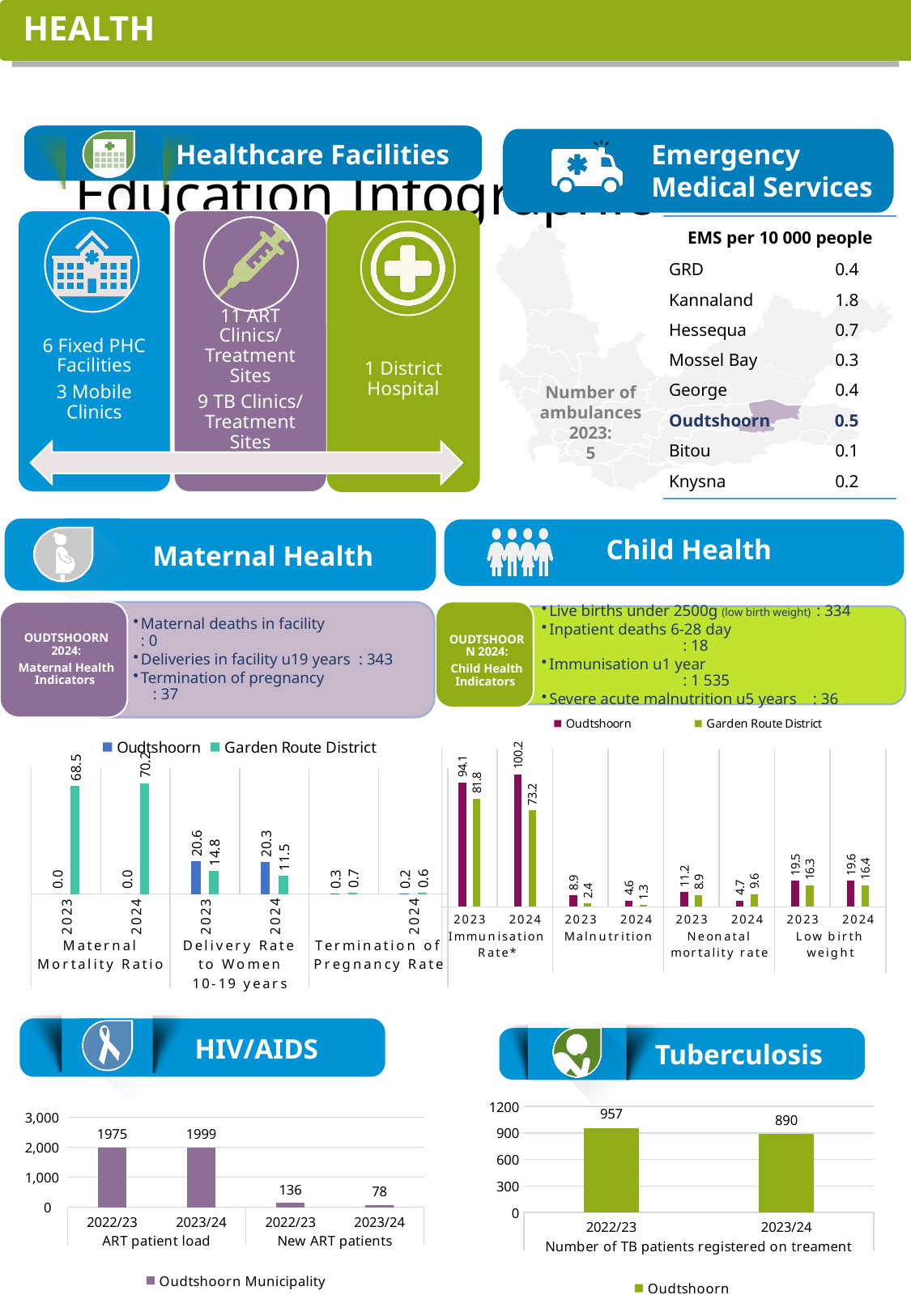
In the Maternal Health chart, how many series does the legend list? 2 In the Child Health chart, what is the difference between the Oudtshoorn and Garden Route District Malnutrition values in 2023? 6.5 In the Tuberculosis chart, what is the number of TB patients registered on treatment for 2022/23? 957 In the HIV/AIDS chart, what is the ART patient load for 2023/24? 1999 In the Child Health chart, which is larger for Neonatal mortality rate in 2024: Oudtshoorn or Garden Route District? Garden Route District In the HIV/AIDS chart, what is the difference in New ART patients between 2022/23 and 2023/24? 58 In the Tuberculosis chart, do the values rise or fall from 2022/23 to 2023/24? fall In the Maternal Health chart, what is the Oudtshoorn Delivery Rate to Women 10-19 years for 2023? 20.6 In the Child Health chart, what is the Oudtshoorn Immunisation Rate for 2024? 100.2 In the Child Health chart, what is the Garden Route District Low birth weight value for 2023? 16.3 In the Maternal Health chart, what is the difference between the Oudtshoorn and Garden Route District Delivery Rate to Women 10-19 years in 2024? 8.8 In the Maternal Health chart, what is the Garden Route District Maternal Mortality Ratio for 2024? 70.2